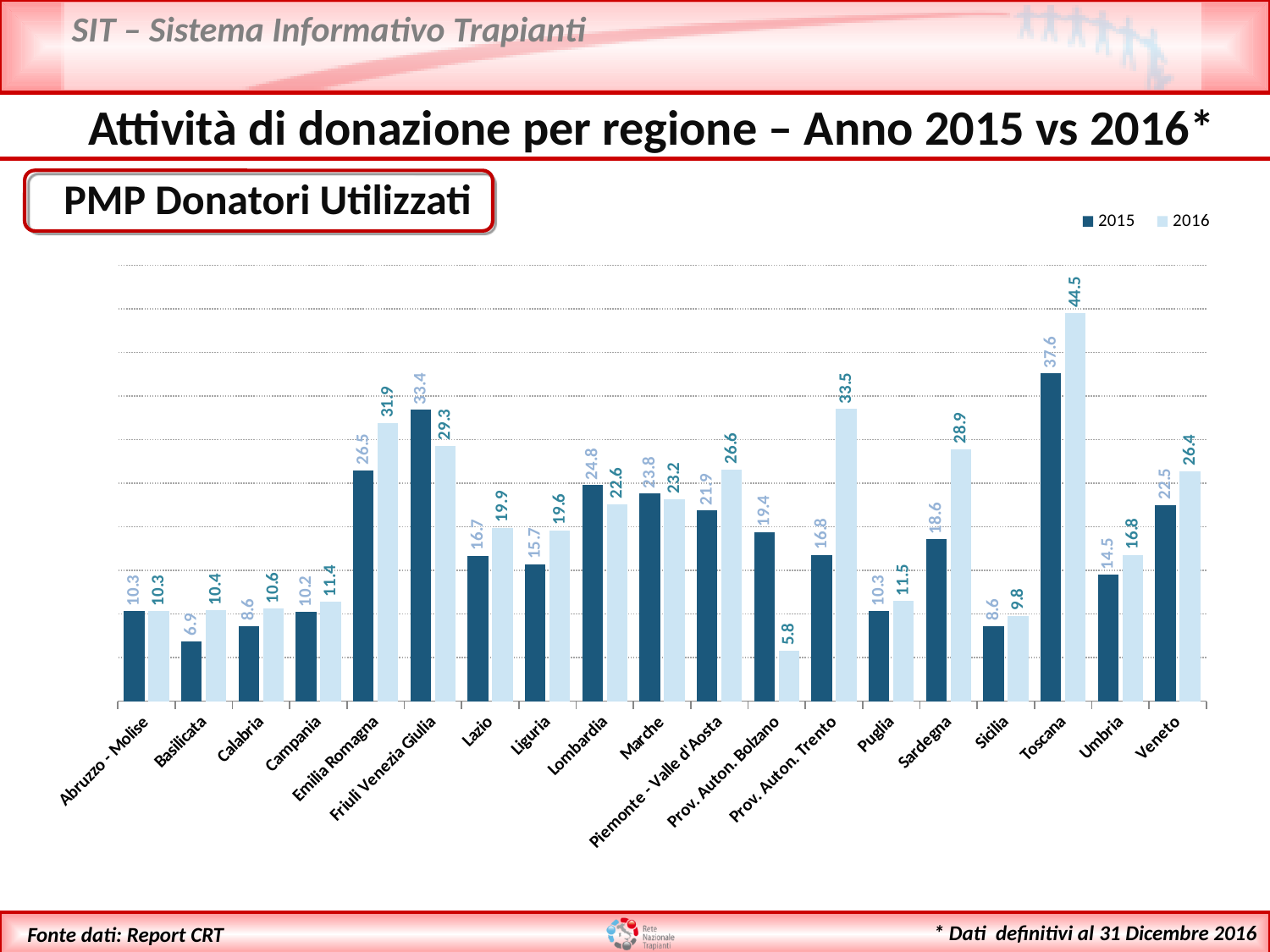
What is the difference between the 2015 and 2016 values for Prov. Auton. Bolzano? 13.6 What is the difference between the 2016 and 2015 values for Toscana? 6.9 What is the 2016 value for Prov. Auton. Trento? 33.5 How many regions are shown on the x axis? 19 Which is larger for Lombardia, the 2015 value or the 2016 value? 2015 What kind of chart is shown on the slide? Bar chart How many series does the legend list? 2 What is the 2015 value for Friuli Venezia Giulia? 33.4 Which region has the highest 2016 value? Toscana Which region has the lowest 2016 value? Prov. Auton. Bolzano What is the 2016 value for Sardegna? 28.9 Which region has the lowest 2015 value? Basilicata